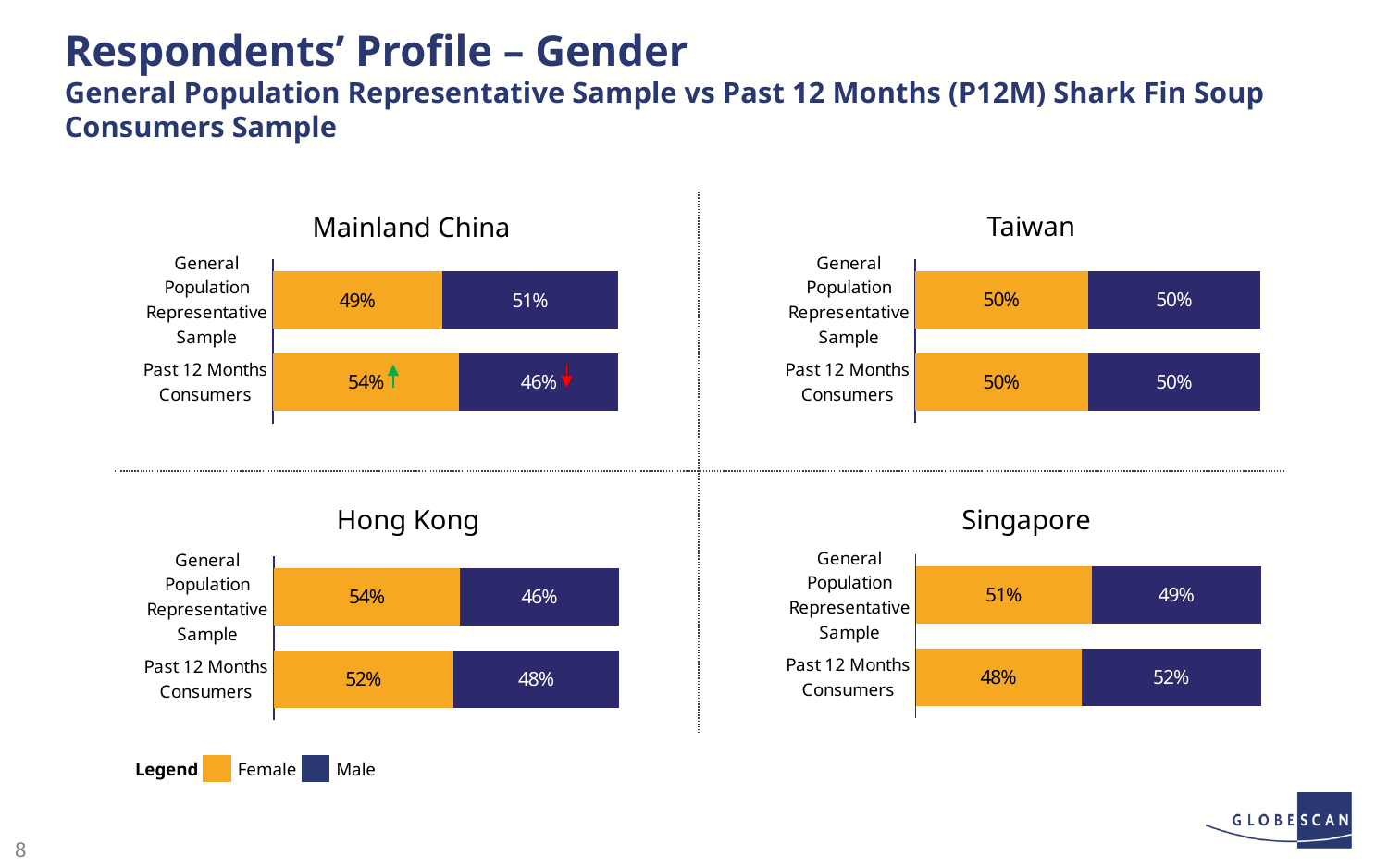
How many categories (bars) does the Taiwan chart show? 2 In the Singapore chart, what is the difference between the female share of the General Population Representative Sample and the female share of the Past 12 Months Consumers sample? 3 percentage points In the Singapore chart, what percentage of the Past 12 Months Consumers sample is female? 48% What kind of chart is used for each country on this slide? Stacked bar chart How many series does the legend list? 2 In the Mainland China chart, what percentage of the General Population Representative Sample is male? 51% In the Taiwan chart, what percentage of the Past 12 Months Consumers sample is male? 50% In the Mainland China chart, what is the total of the Past 12 Months Consumers stacked bar? 100% Which colour represents Male in the legend? Dark blue In the Hong Kong chart, what percentage of the General Population Representative Sample is female? 54% In the Mainland China chart, what percentage of the Past 12 Months Consumers sample is female? 54% In the Hong Kong chart, which is larger for the Past 12 Months Consumers sample: the female share or the male share? Female